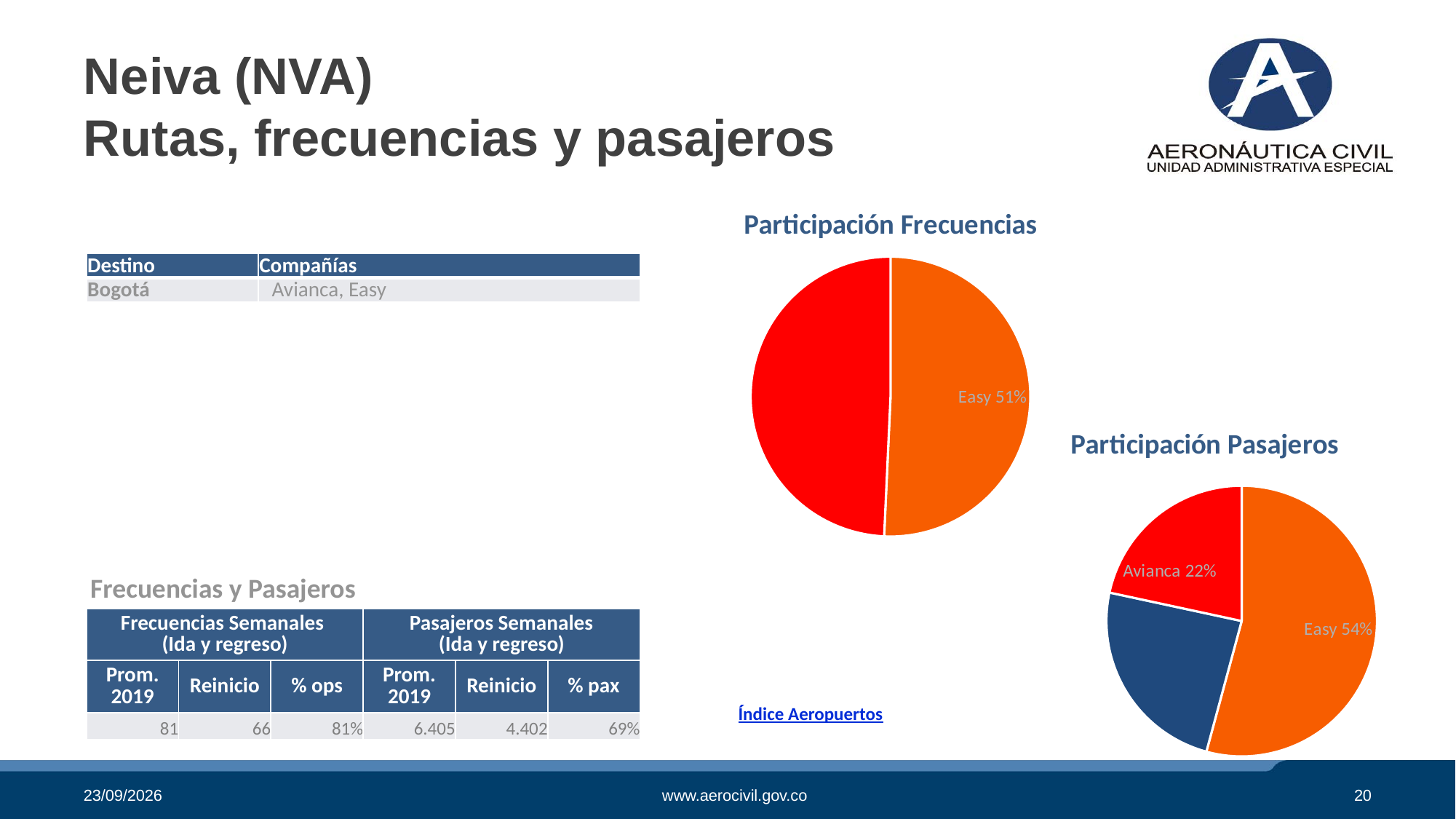
In the "Participación Pasajeros" chart, which labelled slice is the largest? Easy What kind of chart is "Participación Frecuencias"? Pie chart In the "Participación Pasajeros" chart, what colour is the Easy slice? Orange Is Easy's share larger in the "Participación Frecuencias" chart or in the "Participación Pasajeros" chart? Participación Pasajeros How many slices does the "Participación Pasajeros" pie chart have? 3 In the "Participación Pasajeros" chart, what is the difference in percentage points between the Easy share and the Avianca share? 32 percentage points In the "Participación Pasajeros" chart, what share does Avianca have? 22% In the "Participación Pasajeros" chart, which is larger, the Easy slice or the Avianca slice? Easy How many slices does the "Participación Frecuencias" pie chart have? 2 In the "Participación Frecuencias" chart, what share does Easy have? 51% What is the title of the pie chart in the lower right of the slide? Participación Pasajeros In the "Participación Pasajeros" chart, what share does Easy have? 54%